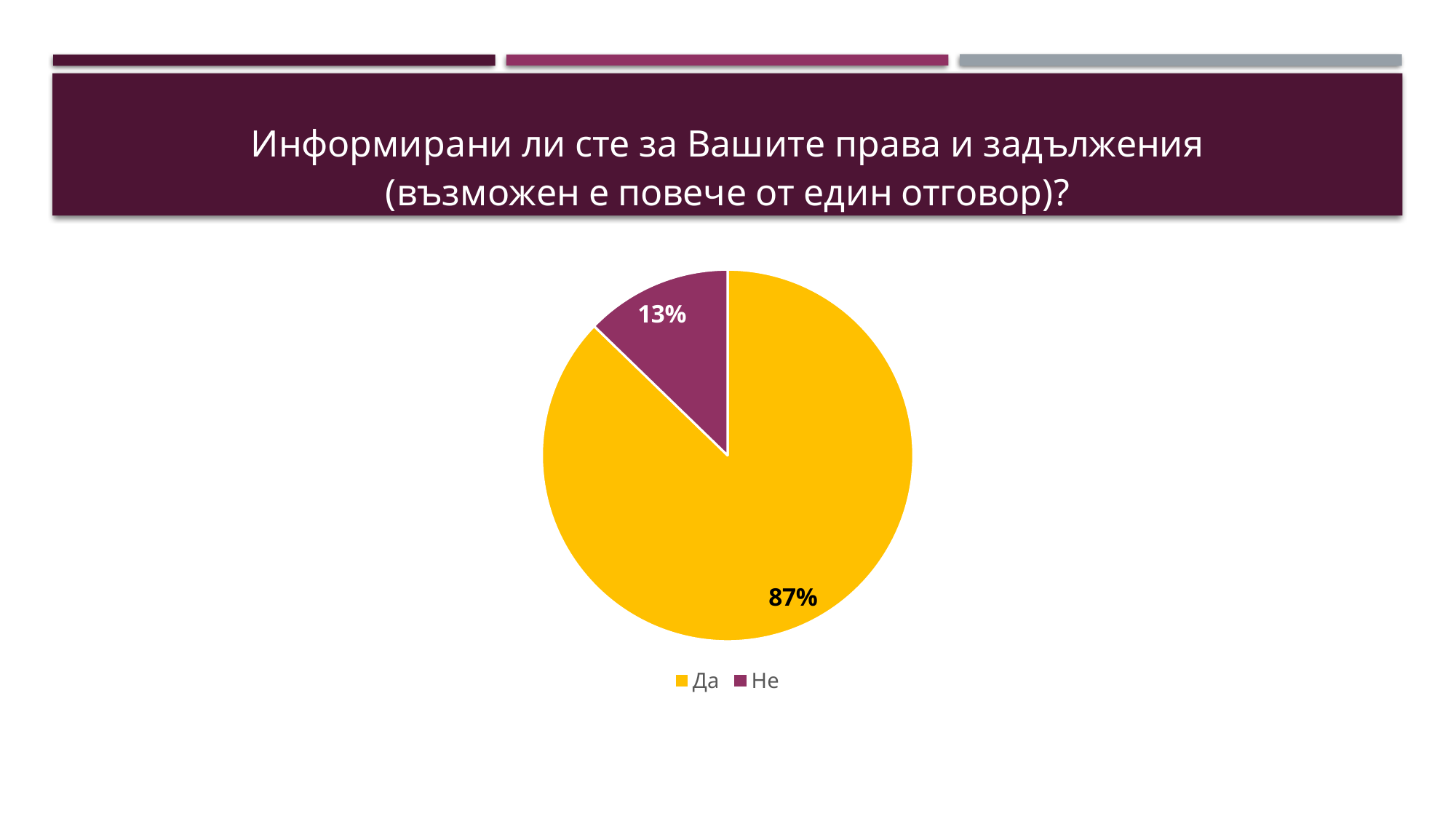
What share of the pie does "Да" take? 87% Which category has the largest slice of the pie? Да Which category has the smallest slice of the pie? Не What share of the pie does "Не" take? 13% How many entries does the legend list? 2 What is the difference in percentage points between the "Да" and "Не" slices? 74 Which slice is larger, "Да" or "Не"? Да What colour is the "Не" slice? purple What colour is the "Да" slice? yellow What kind of chart is shown on the slide? pie chart How many slices does the pie chart have? 2